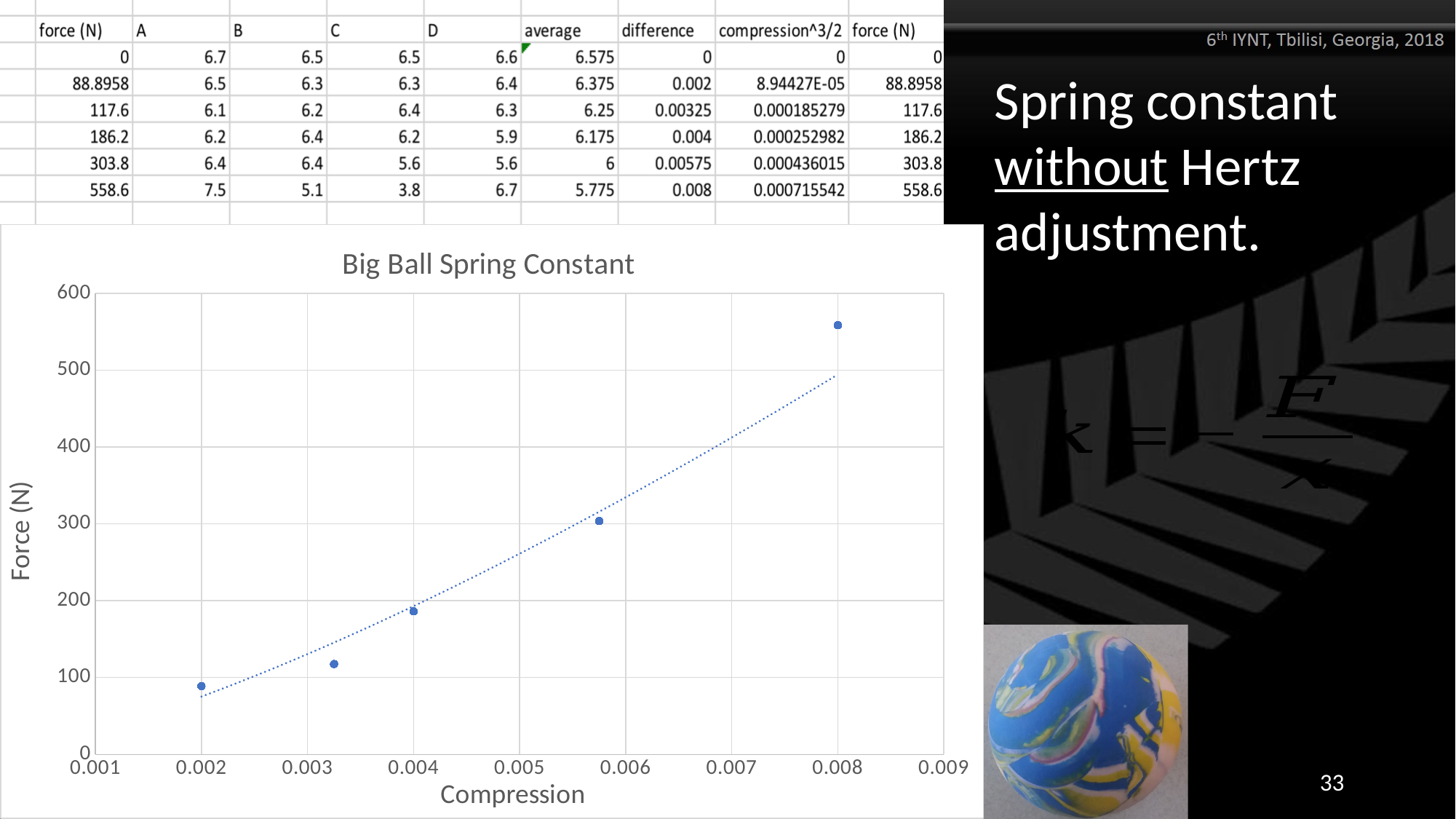
In the 'Big Ball Spring Constant' chart, is the force at compression 0.002 greater or less than 100? less What is the label of the vertical axis in the 'Big Ball Spring Constant' chart? Force (N) In the 'Big Ball Spring Constant' chart, is the force at compression 0.008 greater or less than 500? greater In the 'Big Ball Spring Constant' chart, which has the larger force: the point at compression 0.004 or the point near compression 0.006? the point near 0.006 At which compression value does the 'Big Ball Spring Constant' chart show the highest force? 0.008 How many data points are plotted in the 'Big Ball Spring Constant' chart? 5 In the 'Big Ball Spring Constant' chart, is the force at compression 0.004 greater or less than 200? less What kind of chart is 'Big Ball Spring Constant'? scatter chart In the 'Big Ball Spring Constant' chart, does the force rise or fall as compression increases? rise What is the title of the chart on the slide? Big Ball Spring Constant At which compression value does the 'Big Ball Spring Constant' chart show the lowest force? 0.002